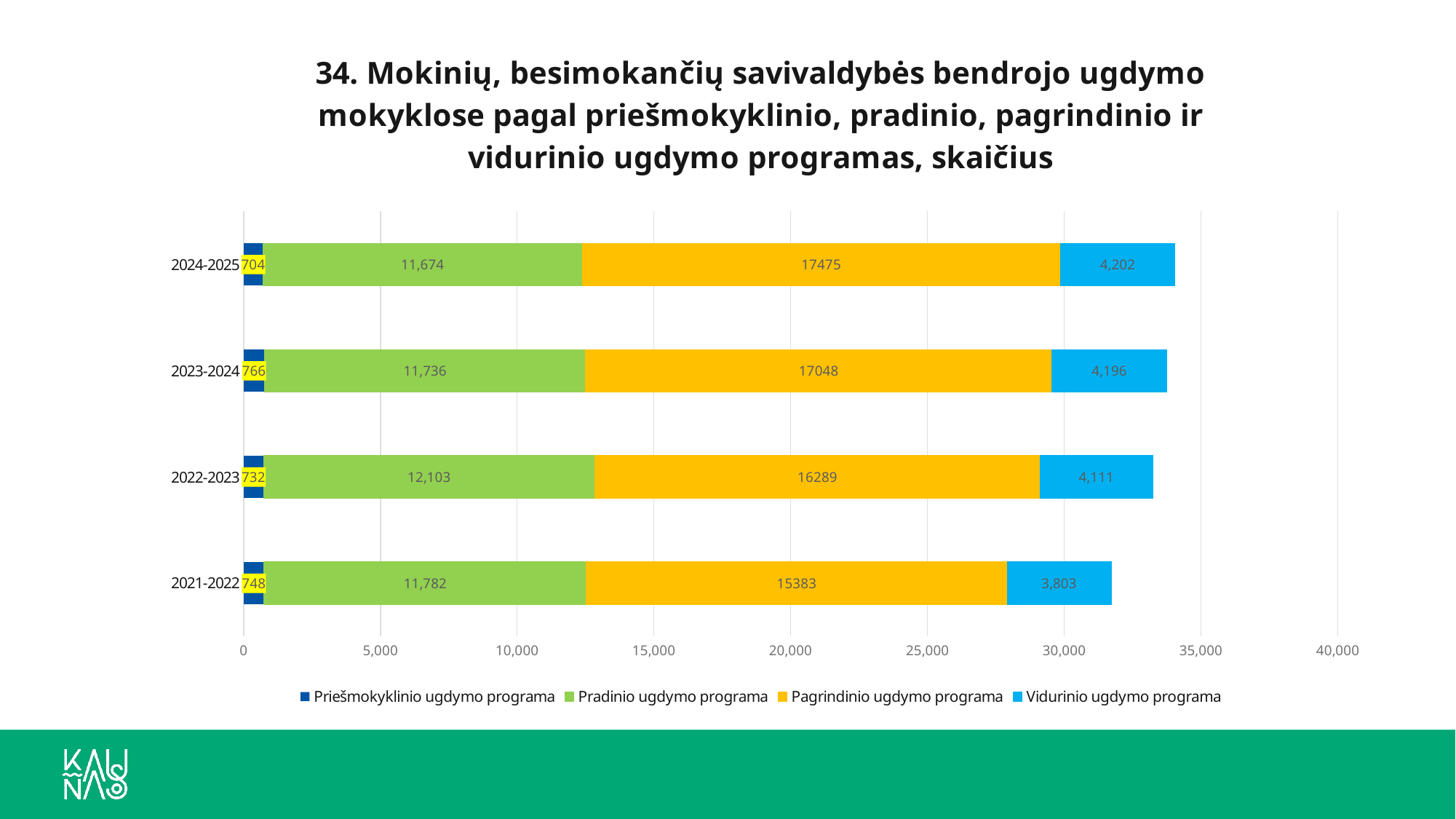
Which is larger: the Pradinio ugdymo programa value for 2022-2023 or for 2024-2025? 2022-2023 In which school year is the Vidurinio ugdymo programa value lowest? 2021-2022 What is the value for Priešmokyklinio ugdymo programa in 2023-2024? 766 How many series does the legend list? 4 In which school year is the Pagrindinio ugdymo programa value highest? 2024-2025 How many school years are shown on the chart? 4 What is the difference between the Pagrindinio ugdymo programa values for 2024-2025 and 2021-2022? 2092 What is the total of the stacked bar for 2021-2022? 31716 What kind of chart is shown on the slide? Stacked bar chart What is the value for Pagrindinio ugdymo programa in 2024-2025? 17475 What is the value for Vidurinio ugdymo programa in 2021-2022? 3,803 What is the value for Pradinio ugdymo programa in 2022-2023? 12,103